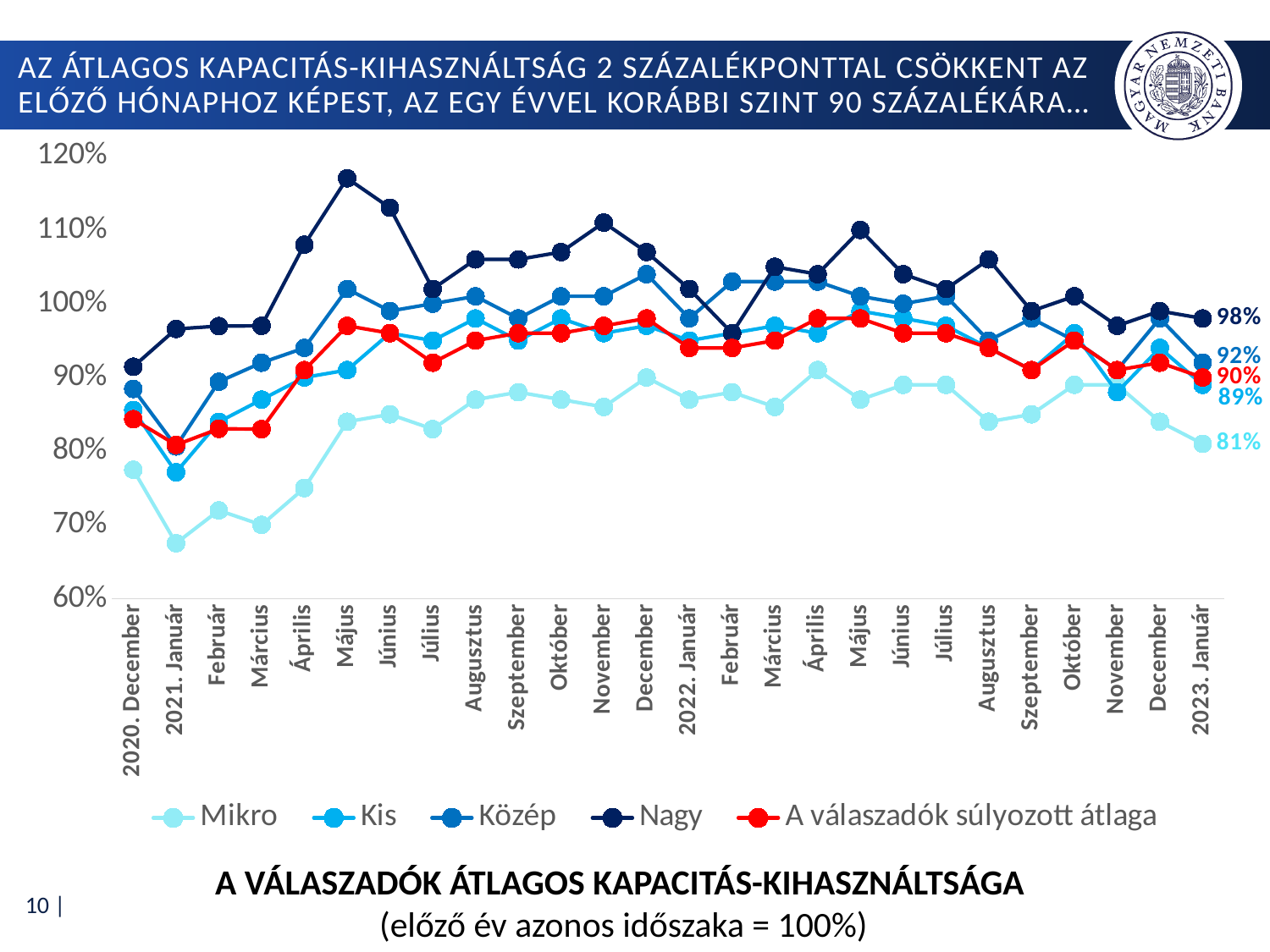
What is the value for Mikro in 2023. Január? 81% In 2023. Január, which is larger: the value for Közép or the value for Kis? Közép Which series has the lowest value in 2023. Január? Mikro Which series has the highest value in 2023. Január? Nagy What is the value for A válaszadók súlyozott átlaga in 2023. Január? 90% What is the difference between the Nagy and Mikro values in 2023. Január? 17 percentage points Is the value for Mikro in 2021. Január greater or less than 70%? less What is the value for Nagy in 2023. Január? 98% What type of chart is shown on the slide? line chart How many months are plotted along the x axis? 26 How many series does the legend list? 5 Is the value for Nagy in 2021 Május greater or less than 110%? greater